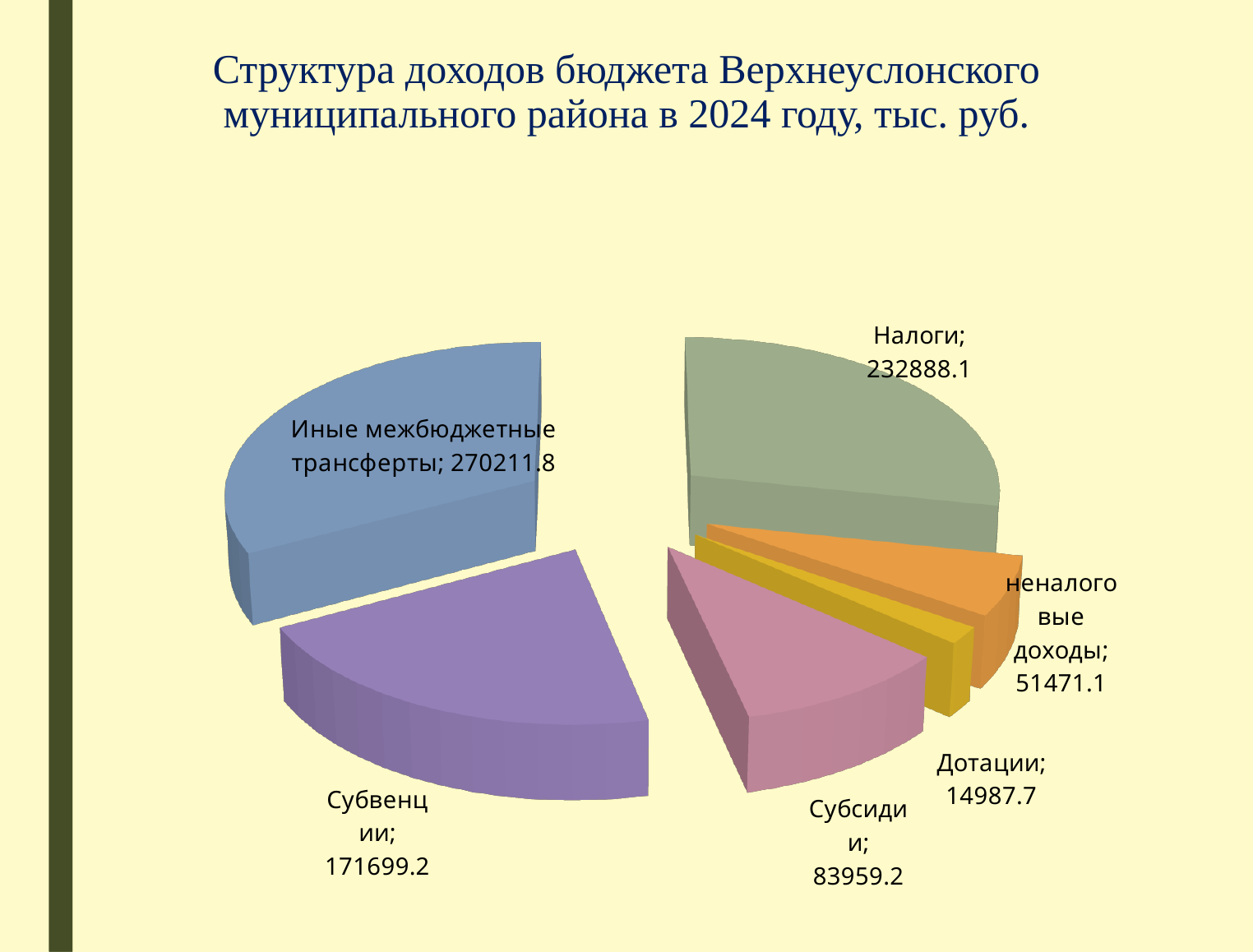
Which category has the largest value? Иные межбюджетные трансферты Which category has the smallest value? Дотации What is the value for Дотации? 14987.7 What is the difference between Иные межбюджетные трансферты and Налоги? 37323.7 What type of chart is shown on the slide? pie chart What is the title of the chart? Структура доходов бюджета Верхнеуслонского муниципального района в 2024 году, тыс. руб. What is the difference between Субвенции and Субсидии? 87740.0 What is the value for Налоги? 232888.1 What is the value for неналоговые доходы? 51471.1 Which is larger, Субсидии or неналоговые доходы? Субсидии What is the value for Субвенции? 171699.2 How many slices does the pie chart have? 6